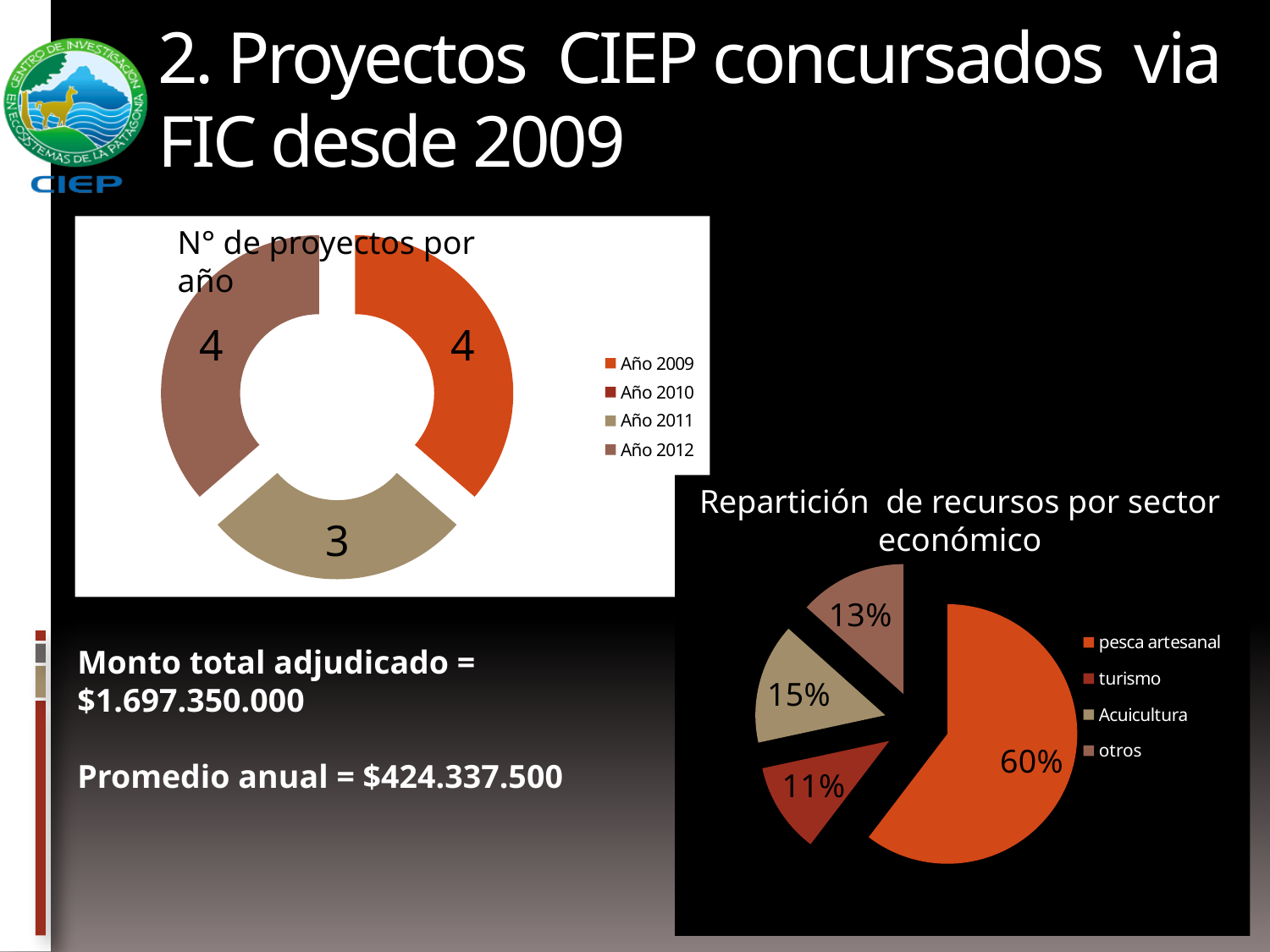
In the chart titled 'Repartición de recursos por sector económico', what share goes to turismo? 11% In the chart titled 'Repartición de recursos por sector económico', which sector has the smallest share? turismo What kind of chart is the one titled 'Repartición de recursos por sector económico'? pie chart In the chart titled 'Repartición de recursos por sector económico', which is larger, Acuicultura or otros? Acuicultura In the chart titled 'Repartición de recursos por sector económico', what share goes to otros? 13% In the chart titled 'Repartición de recursos por sector económico', what share goes to Acuicultura? 15% In the chart titled 'Repartición de recursos por sector económico', what share goes to pesca artesanal? 60% In the chart titled 'Repartición de recursos por sector económico', how many entries does the legend list? 4 In the chart titled 'Repartición de recursos por sector económico', which sector has the largest share? pesca artesanal In the chart titled 'Repartición de recursos por sector económico', how many percentage points larger is pesca artesanal than Acuicultura? 45 In the chart titled 'N° de proyectos por año', what is the value for Año 2011? 3 In the chart titled 'N° de proyectos por año', what is the value for Año 2009? 4